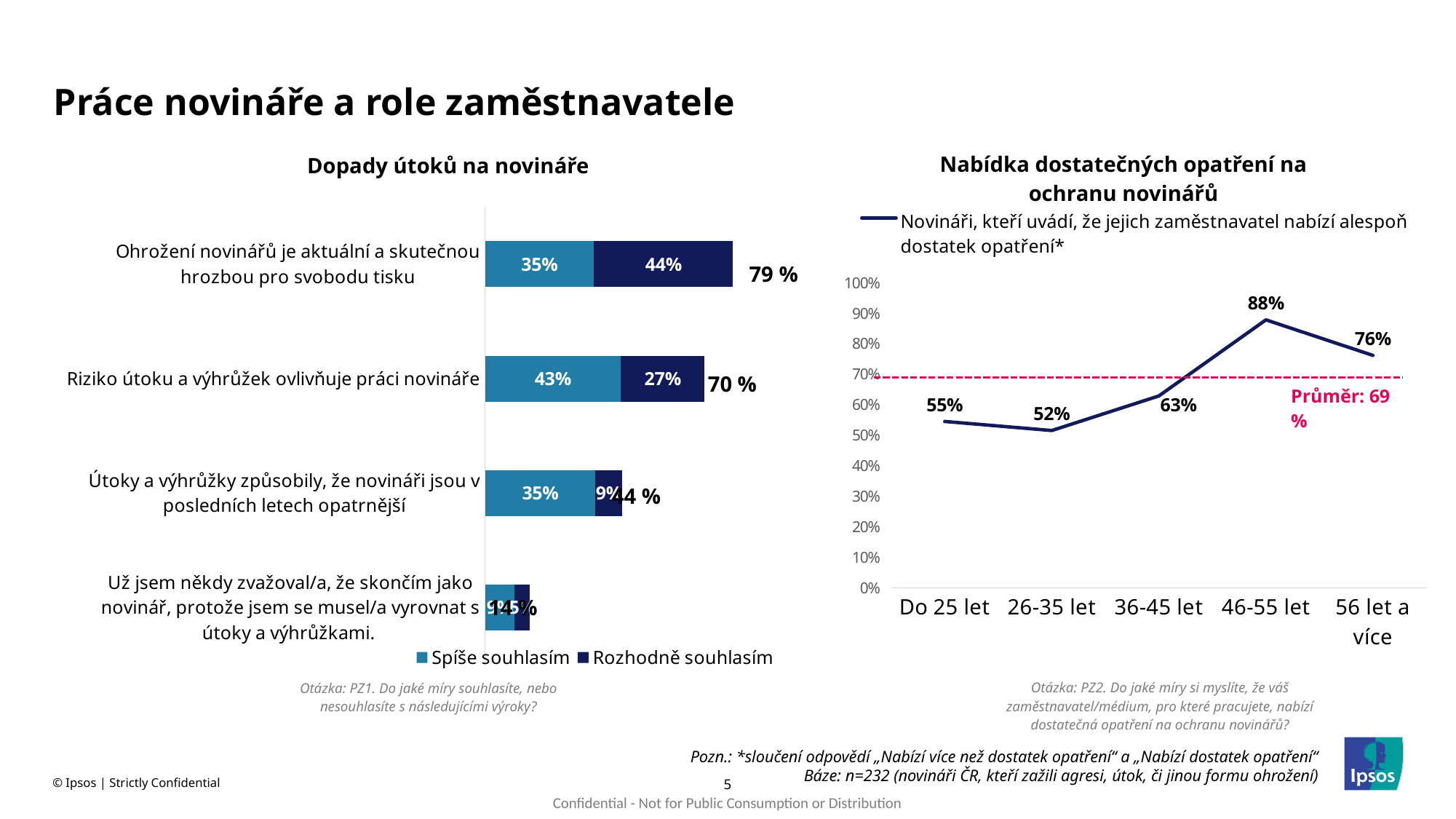
In the chart "Dopady útoků na novináře", what is the total of the stacked bar for "Riziko útoku a výhrůžek ovlivňuje práci novináře"? 70 % In the chart "Nabídka dostatečných opatření na ochranu novinářů", which age group has the highest value? 46-55 let In the chart "Nabídka dostatečných opatření na ochranu novinářů", what is the value for "36-45 let"? 63% In the chart "Nabídka dostatečných opatření na ochranu novinářů", what average value is marked by the dashed line? 69 % In the chart "Nabídka dostatečných opatření na ochranu novinářů", what is the difference between the values for "46-55 let" and "56 let a více"? 12 percentage points What kind of chart is the left chart titled "Dopady útoků na novináře"? bar chart How many age groups are plotted on the x axis of the chart "Nabídka dostatečných opatření na ochranu novinářů"? 5 In the chart "Dopady útoků na novináře", what is the "Spíše souhlasím" value for "Riziko útoku a výhrůžek ovlivňuje práci novináře"? 43% In the chart "Dopady útoků na novináře", what is the "Rozhodně souhlasím" value for "Ohrožení novinářů je aktuální a skutečnou hrozbou pro svobodu tisku"? 44% How many series does the legend of the chart "Dopady útoků na novináře" list? 2 In the chart "Nabídka dostatečných opatření na ochranu novinářů", which age group has the lowest value? 26-35 let What kind of chart is the right chart titled "Nabídka dostatečných opatření na ochranu novinářů"? line chart